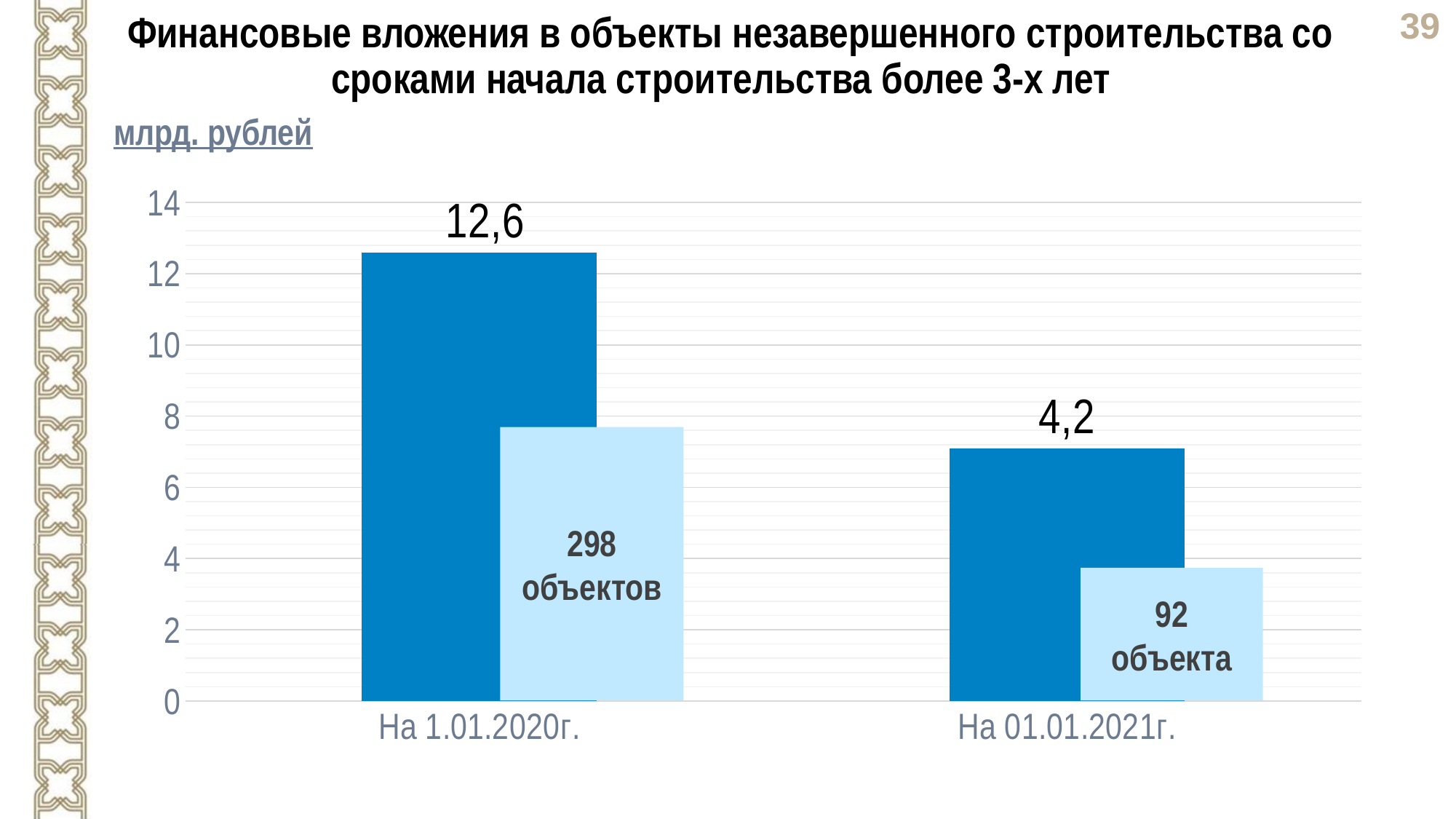
Which category has the lowest dark blue bar? На 01.01.2021г. Which is larger: the dark blue bar for На 1.01.2020г. or for На 01.01.2021г.? На 1.01.2020г. How many categories are shown on the x axis? 2 What label is printed inside the light blue bar for На 1.01.2020г.? 298 объектов Is the light blue bar for На 1.01.2020г. greater or less than 6? greater What is the value of the dark blue bar for На 1.01.2020г.? 12,6 What is the difference between the dark blue bar values for На 1.01.2020г. and На 01.01.2021г.? 8,4 Which category has the highest dark blue bar? На 1.01.2020г. What kind of chart is shown on the slide? bar chart Do the dark blue bar values rise or fall from На 1.01.2020г. to На 01.01.2021г.? fall What is the value of the dark blue bar for На 01.01.2021г.? 4,2